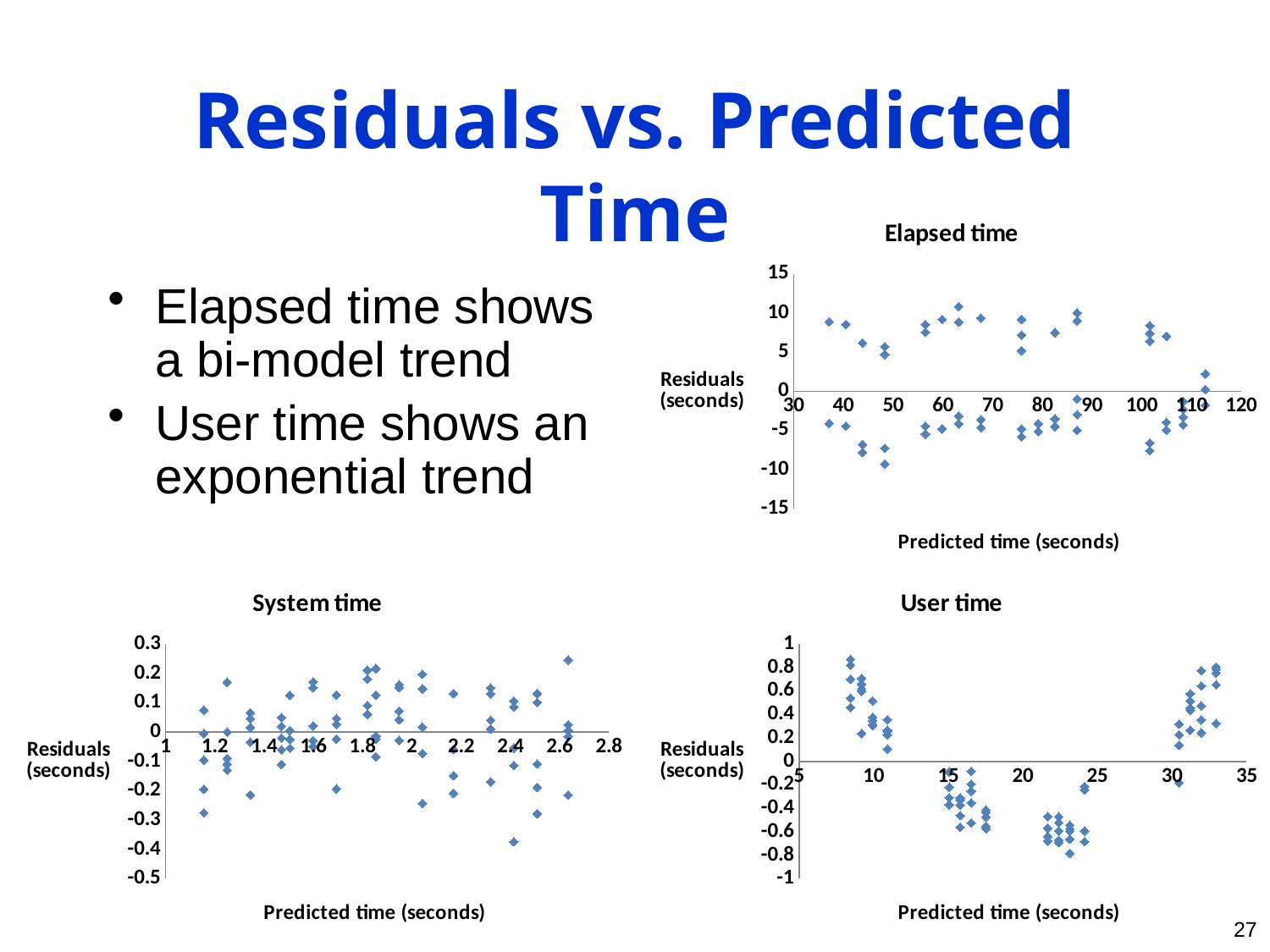
In the 'System time' chart, is the highest residual greater or less than 0.3? less In the 'User time' chart, is the lowest residual greater or less than -1? greater In the 'User time' chart, are the residuals for predicted times around 22 seconds greater or less than 0? less How many charts are shown on the slide? 3 What is the x-axis title of the 'System time' chart? Predicted time (seconds) What kind of chart is the 'User time' chart? scatter chart What kind of chart is the 'Elapsed time' chart? scatter chart